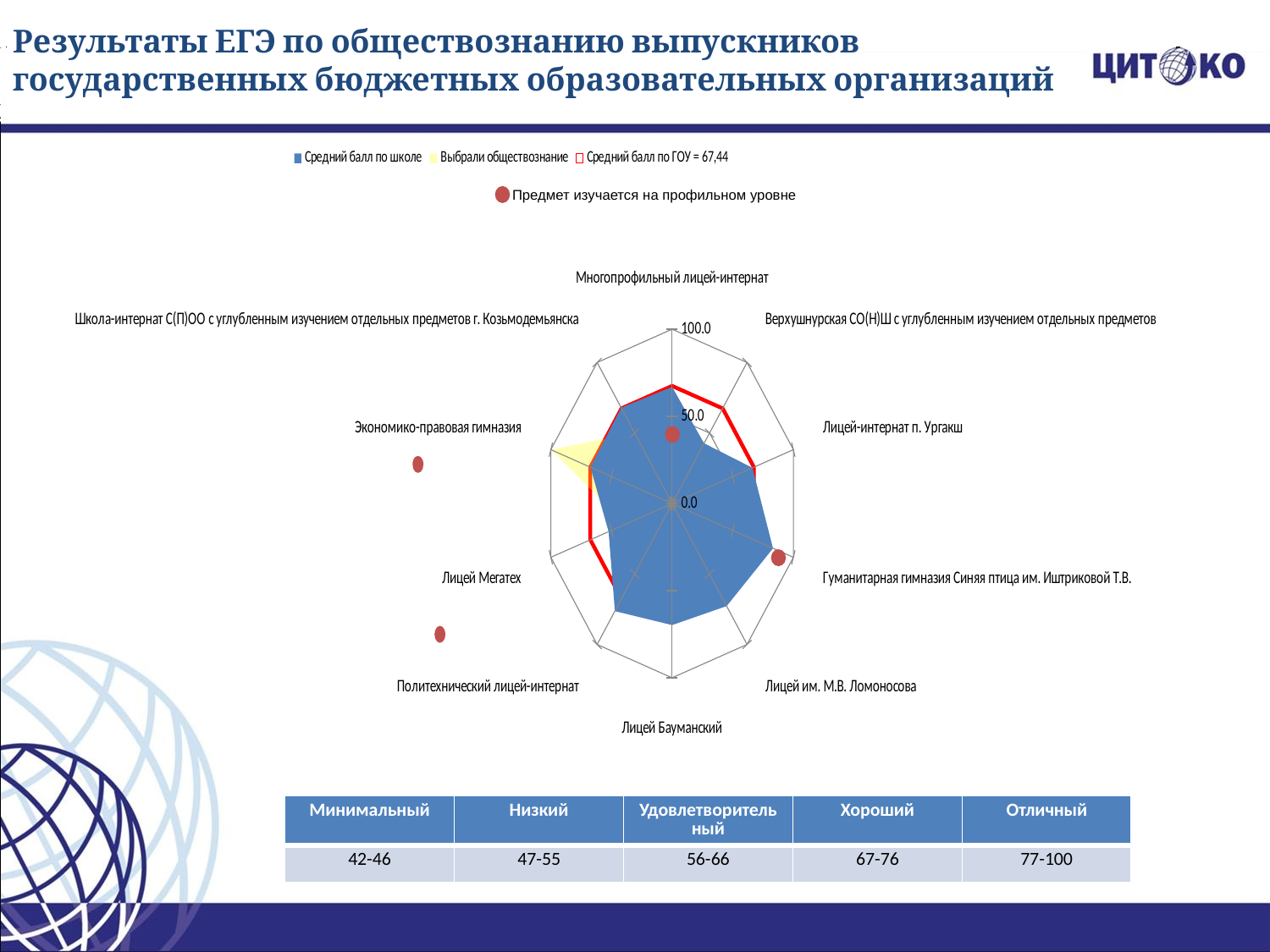
Which has the larger 'Средний балл по школе': Гуманитарная гимназия Синяя птица им. Иштриковой Т.В. or Экономико-правовая гимназия? Гуманитарная гимназия Синяя птица им. Иштриковой Т.В. Which school has the highest 'Средний балл по школе' on the radar chart? Гуманитарная гимназия Синяя птица им. Иштриковой Т.В. Is the 'Средний балл по школе' for Гуманитарная гимназия Синяя птица им. Иштриковой Т.В. greater or less than 50.0? greater What kind of chart is shown on the slide? radar chart What value is given in the legend for 'Средний балл по ГОУ'? 67,44 How many schools (categories) are plotted on the radar chart? 10 What is the maximum value shown on the radar chart's axis? 100.0 Is the 'Средний балл по школе' for Лицей-интернат п. Ургакш greater or less than 50.0? greater Which series is drawn in blue on the radar chart? Средний балл по школе How many series does the chart legend list? 3